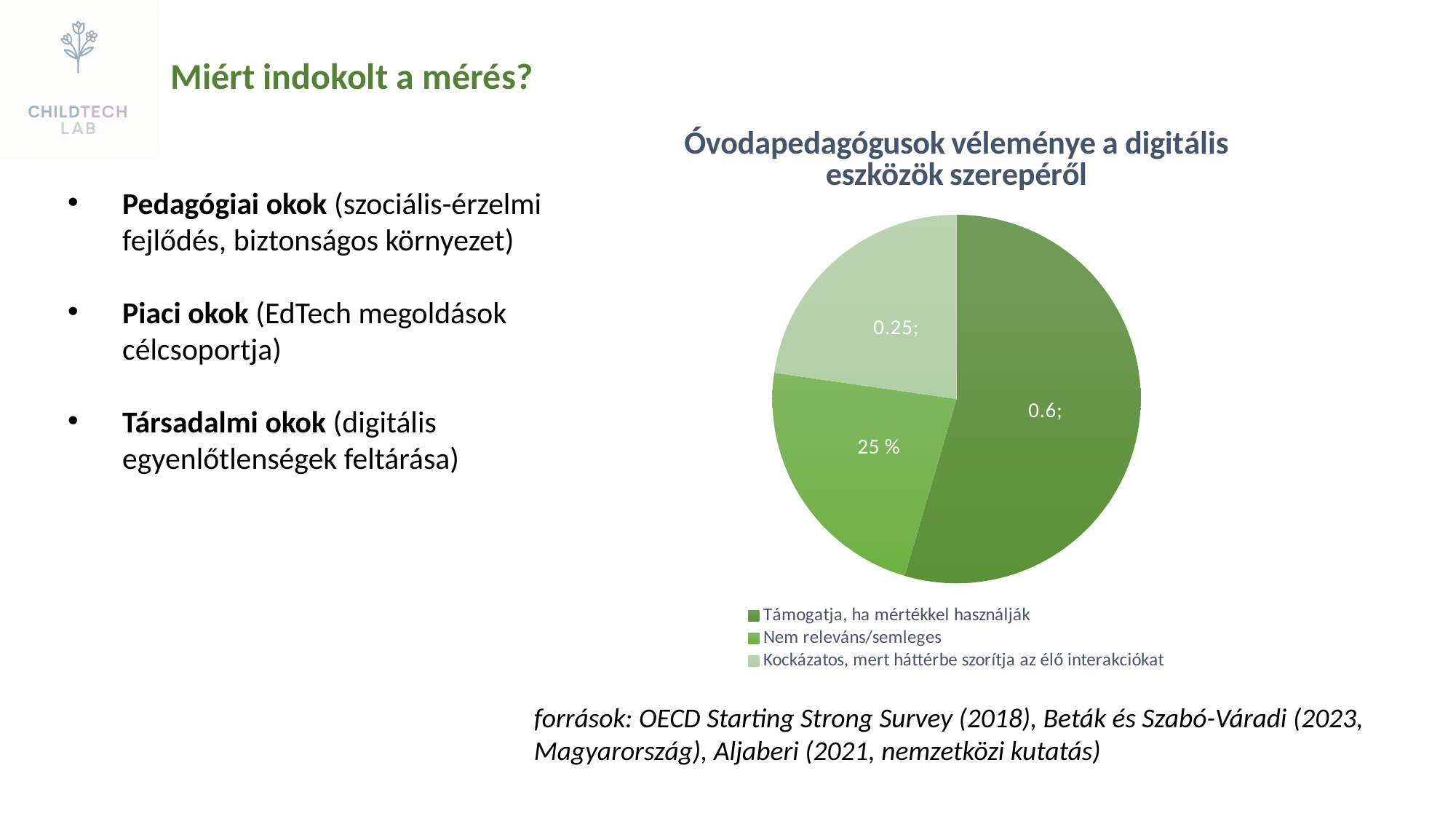
What is the title of the chart? Óvodapedagógusok véleménye a digitális eszközök szerepéről What value is printed on the 'Kockázatos, mert háttérbe szorítja az élő interakciókat' slice? 0.25 How many slices does the pie chart have? 3 What kind of chart is shown on the slide? pie chart Which legend entry is shown in the lightest green colour? Kockázatos, mert háttérbe szorítja az élő interakciókat What value is printed on the 'Támogatja, ha mértékkel használják' slice? 0.6 How many entries does the chart legend list? 3 Which slice is larger: 'Támogatja, ha mértékkel használják' or 'Kockázatos, mert háttérbe szorítja az élő interakciókat'? Támogatja, ha mértékkel használják What value is printed on the 'Nem releváns/semleges' slice? 25 % Which category has the largest slice of the pie? Támogatja, ha mértékkel használják What share of the pie does the 'Nem releváns/semleges' slice represent? 25 %